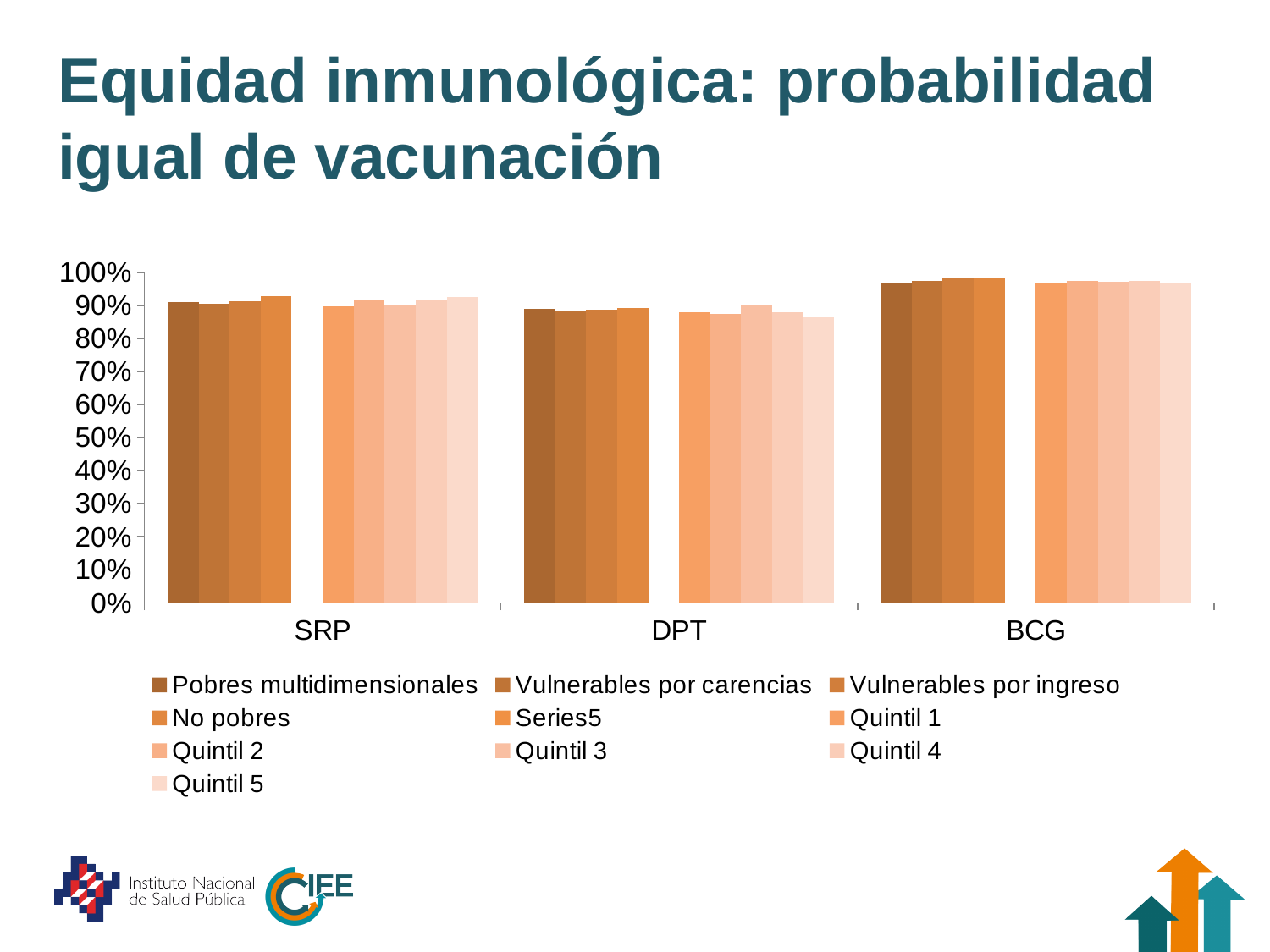
How many series does the chart's legend list? 10 Which category on the x axis has the highest bars overall? BCG Is the value for Quintil 3 in SRP greater or less than 80%? greater How many categories are shown on the x axis of the chart? 3 Is the value for Quintil 1 in DPT greater or less than 80%? greater What kind of chart is shown on the slide? bar chart Is the value for Pobres multidimensionales in BCG greater or less than 90%? greater Which is larger: the value for Quintil 5 in SRP or in DPT? SRP Which category on the x axis has the lowest bars overall? DPT Which is larger: the value for Pobres multidimensionales in BCG or in DPT? BCG What is the title of the slide containing the chart? Equidad inmunológica: probabilidad igual de vacunación